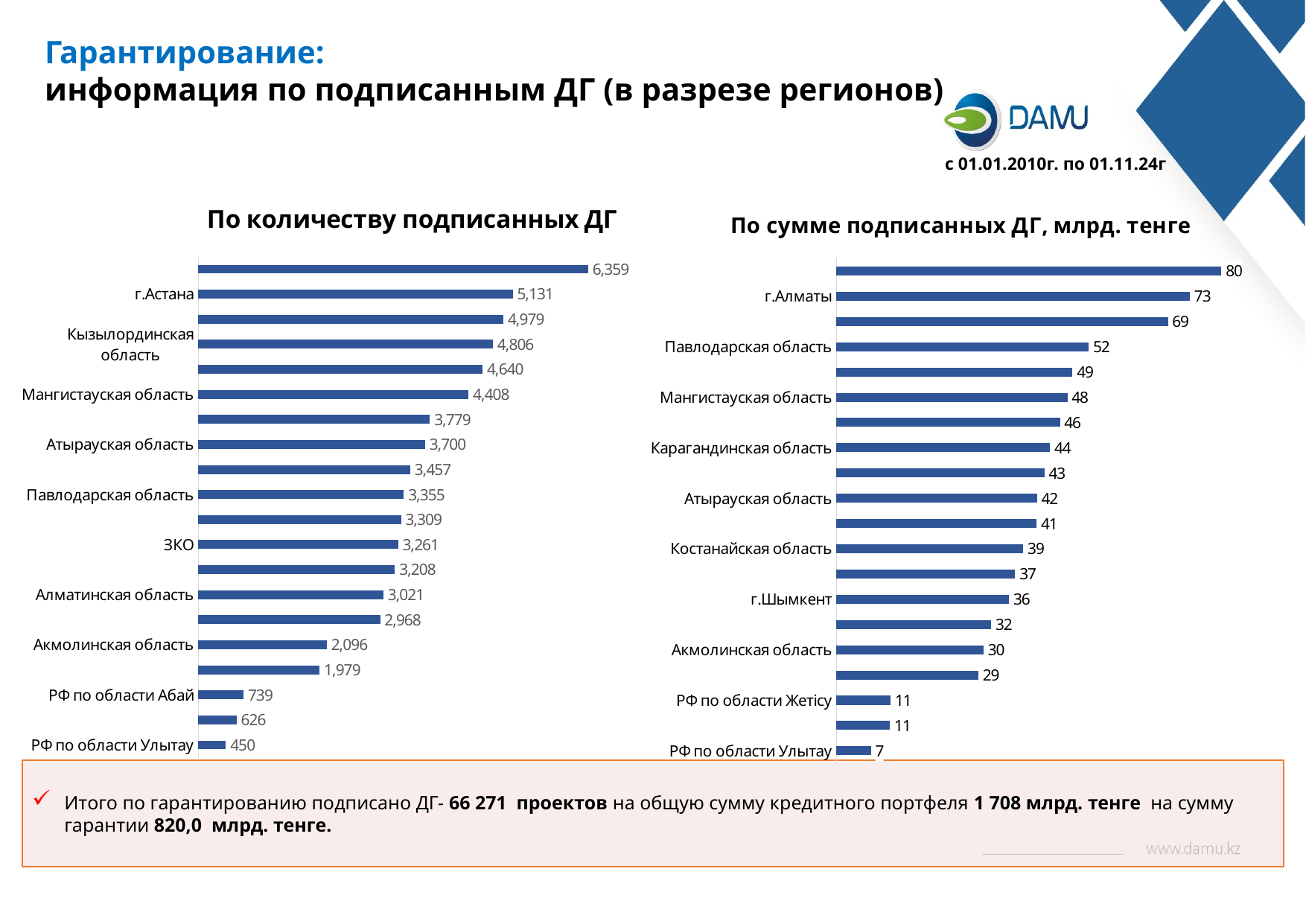
In the chart 'По сумме подписанных ДГ, млрд. тенге', which labelled region has the lowest value? РФ по области Улытау In the chart 'По количеству подписанных ДГ', what is the difference between г.Астана and Акмолинская область? 3,035 In the chart 'По сумме подписанных ДГ, млрд. тенге', what is the value for г.Шымкент? 36 In the chart 'По количеству подписанных ДГ', what is the value for Мангистауская область? 4,408 In the chart 'По количеству подписанных ДГ', what is the value for г.Астана? 5,131 In the chart 'По количеству подписанных ДГ', which labelled region has the lowest value? РФ по области Улытау What type of chart is 'По количеству подписанных ДГ'? Bar chart In the chart 'По количеству подписанных ДГ', what is the largest value shown? 6,359 In the chart 'По сумме подписанных ДГ, млрд. тенге', which is larger: Карагандинская область or Костанайская область? Карагандинская область How many bars are plotted in the chart 'По сумме подписанных ДГ, млрд. тенге'? 20 In the chart 'По сумме подписанных ДГ, млрд. тенге', what is the difference between г.Алматы and Атырауская область? 31 In the chart 'По сумме подписанных ДГ, млрд. тенге', what is the value for Павлодарская область? 52